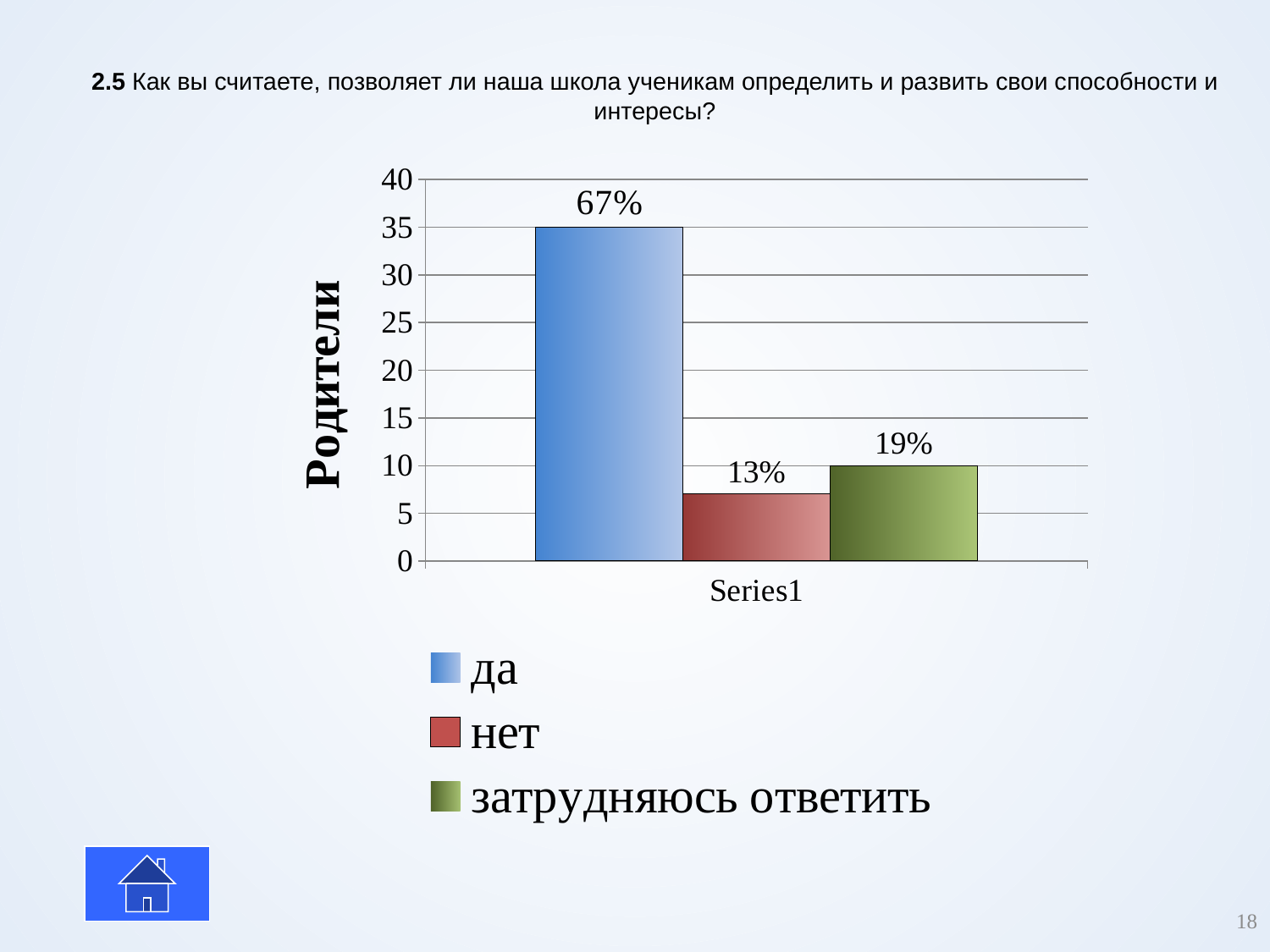
How many entries does the legend list? 3 What kind of chart is shown on the slide? bar chart Which response has the shortest bar? нет Which response has the tallest bar? да Is the value for "нет" greater or less than 10 on the vertical axis? less What is the difference between the data labels for "да" and "нет"? 54% Which is larger, the bar for "нет" or the bar for "затрудняюсь ответить"? затрудняюсь ответить How many bars are plotted in the chart? 3 Is the value for "да" greater or less than 30 on the vertical axis? greater What data label is shown on the bar for "затрудняюсь ответить"? 19% What data label is shown on the bar for "нет"? 13% What data label is shown on the bar for "да"? 67%